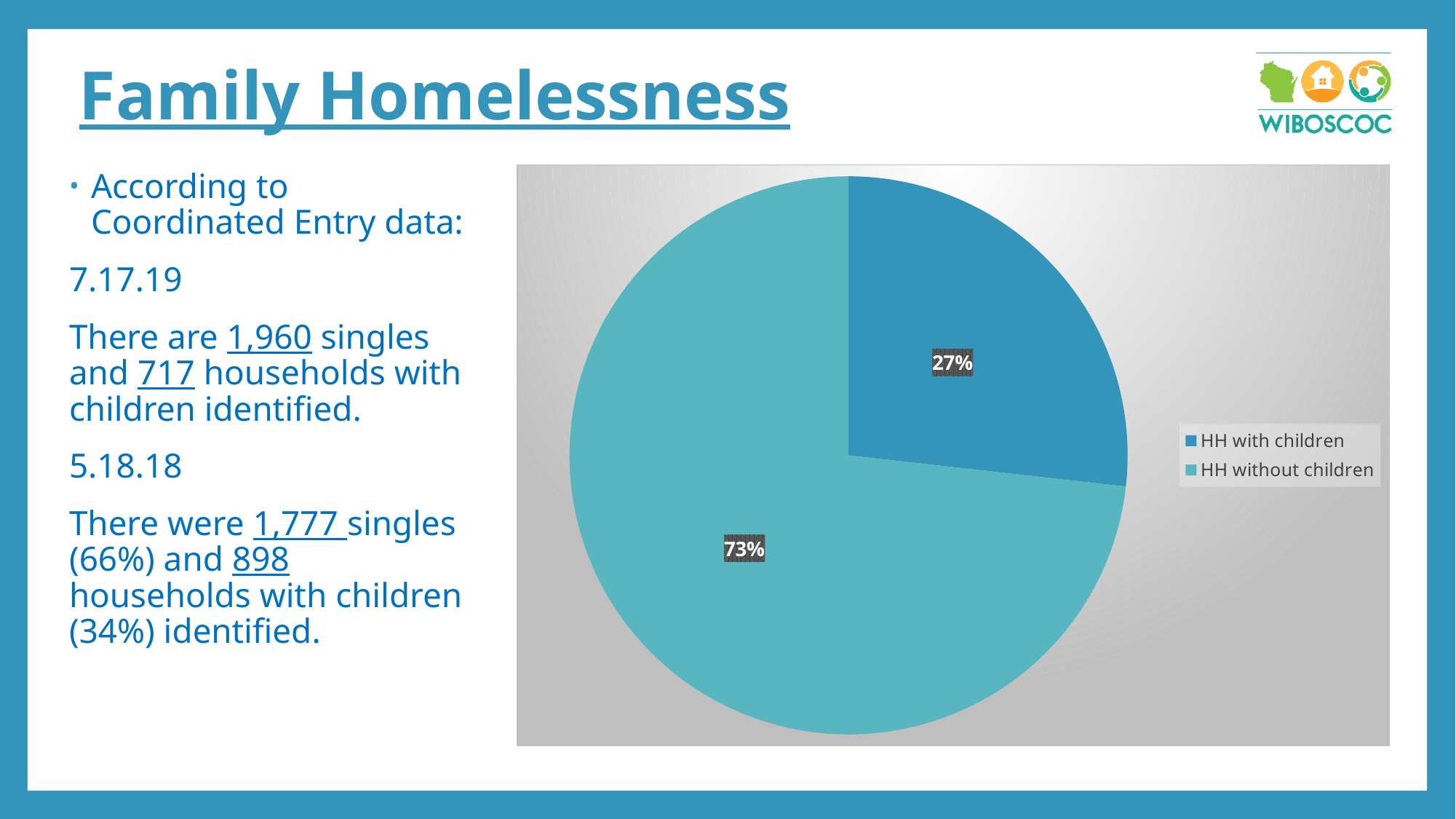
Where is the legend positioned relative to the pie? to the right Which slice of the pie is the smallest? HH with children How many slices does the pie chart have? 2 Which slice of the pie is the largest? HH without children What share of the pie does the 'HH with children' slice represent? 27% Which is larger: the 'HH with children' slice or the 'HH without children' slice? HH without children What share of the pie does the 'HH without children' slice represent? 73% How many entries does the legend list? 2 What is the difference in percentage points between the 'HH without children' and 'HH with children' slices? 46 What colour is the 'HH without children' slice? teal What type of chart is shown on the slide? pie chart